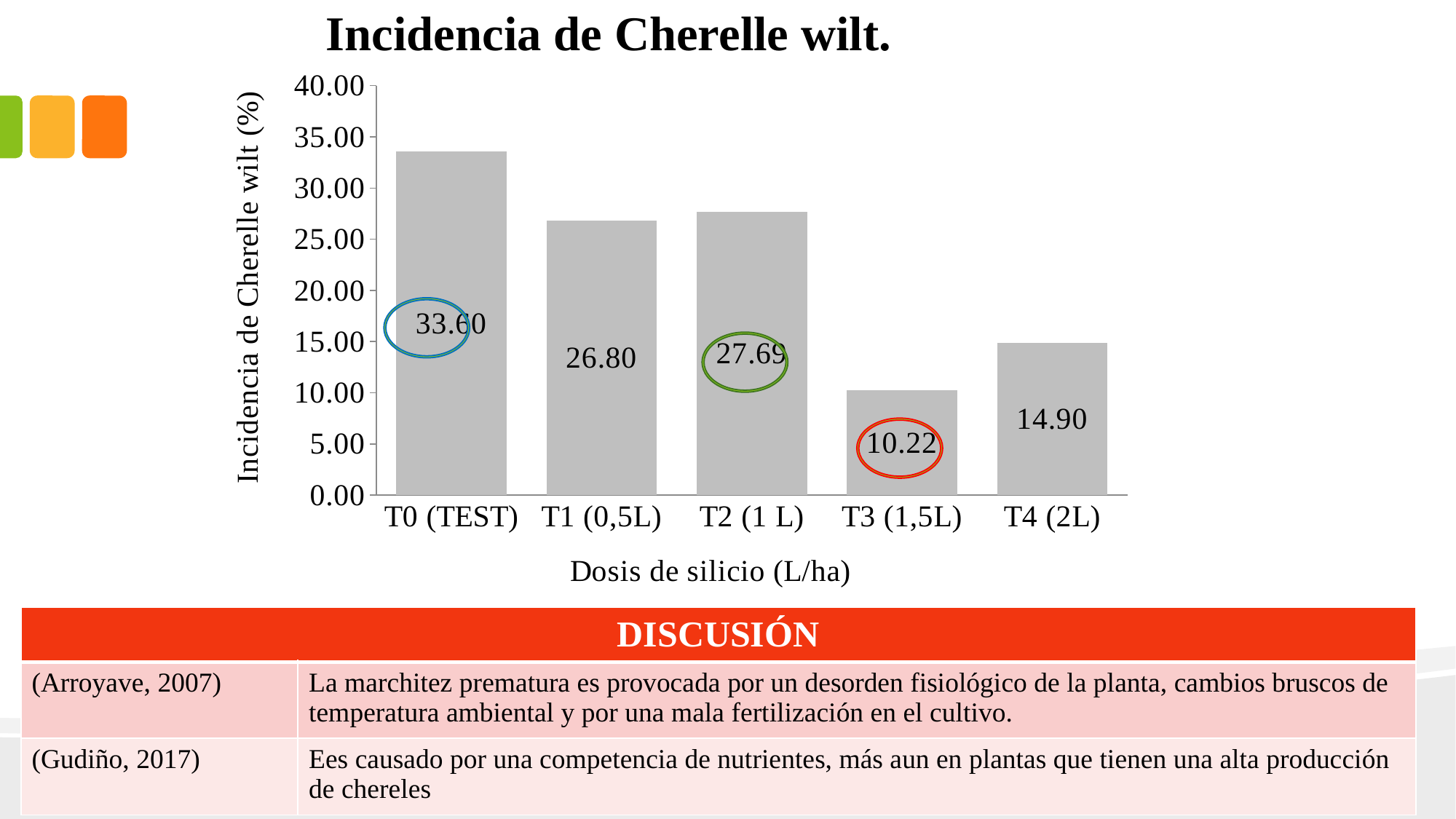
What is the difference between the values for T2 (1 L) and T1 (0,5L)? 0.89 What is the label of the x axis of the chart? Dosis de silicio (L/ha) Which treatment has the highest incidence of Cherelle wilt? T0 (TEST) What is the difference between the values for T0 (TEST) and T3 (1,5L)? 23.38 Which treatment has the lowest incidence of Cherelle wilt? T3 (1,5L) What type of chart is shown on the slide? bar chart Is the value for T4 (2L) greater or less than 20.00? less Which has a higher incidence of Cherelle wilt, T1 (0,5L) or T4 (2L)? T1 (0,5L) What is the incidence of Cherelle wilt for T3 (1,5L)? 10.22 How many treatments (bars) are shown in the chart? 5 What is the incidence of Cherelle wilt for T0 (TEST)? 33.60 What is the value shown for T4 (2L)? 14.90